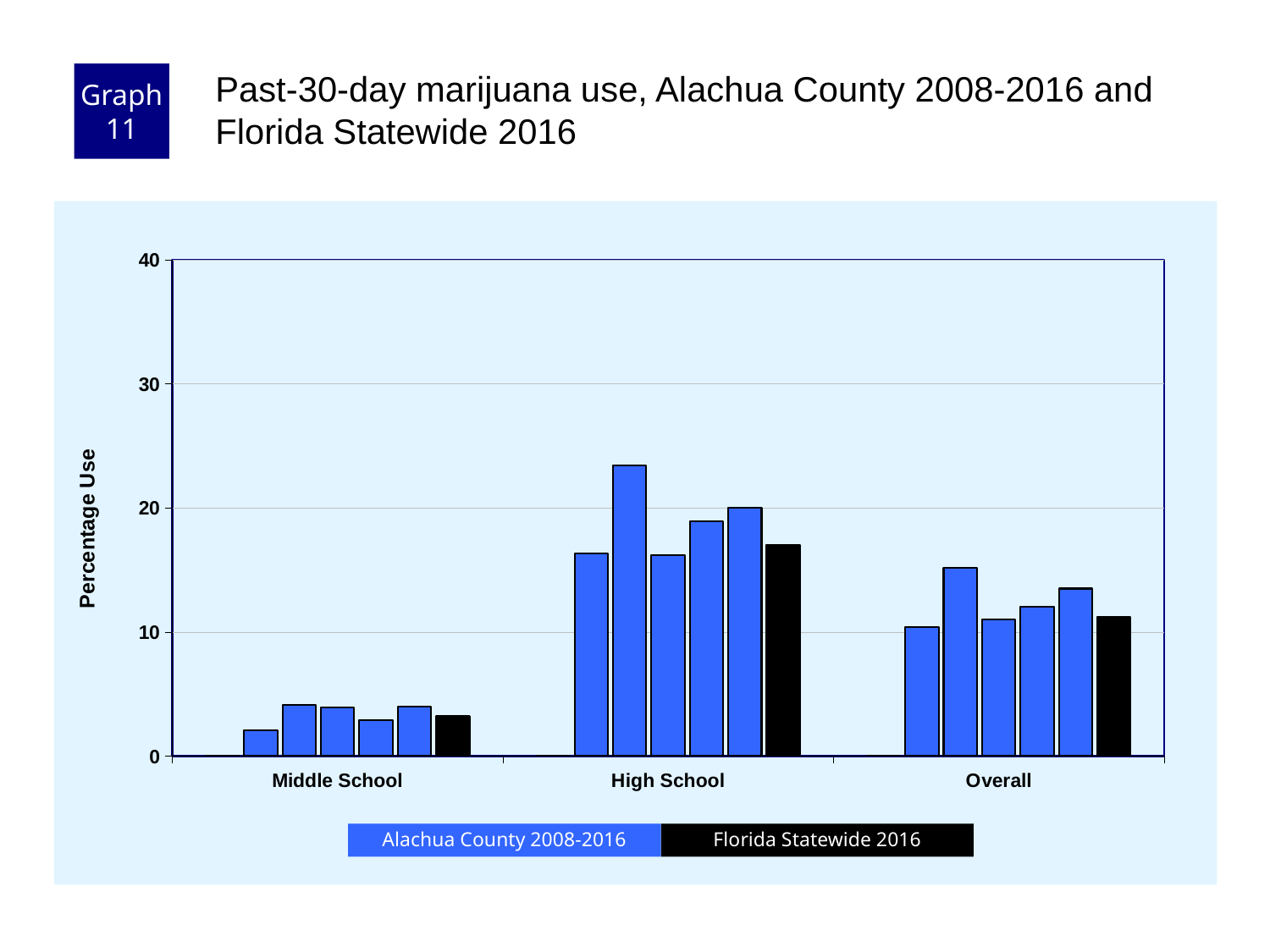
Is the Florida Statewide 2016 value for Middle School greater or less than 10? less Is the tallest Alachua County 2008-2016 bar for High School greater or less than 20? greater Which category has the highest bars? High School Which is larger, the Florida Statewide 2016 value for High School or for Middle School? High School How many categories are shown on the x axis? 3 Is the Florida Statewide 2016 value for High School greater or less than 20? less Which colour represents Florida Statewide 2016 in the legend? black Which category has the lowest bars? Middle School What kind of chart is shown on the slide? bar chart How many series does the legend list? 2 What is the label on the y axis? Percentage Use